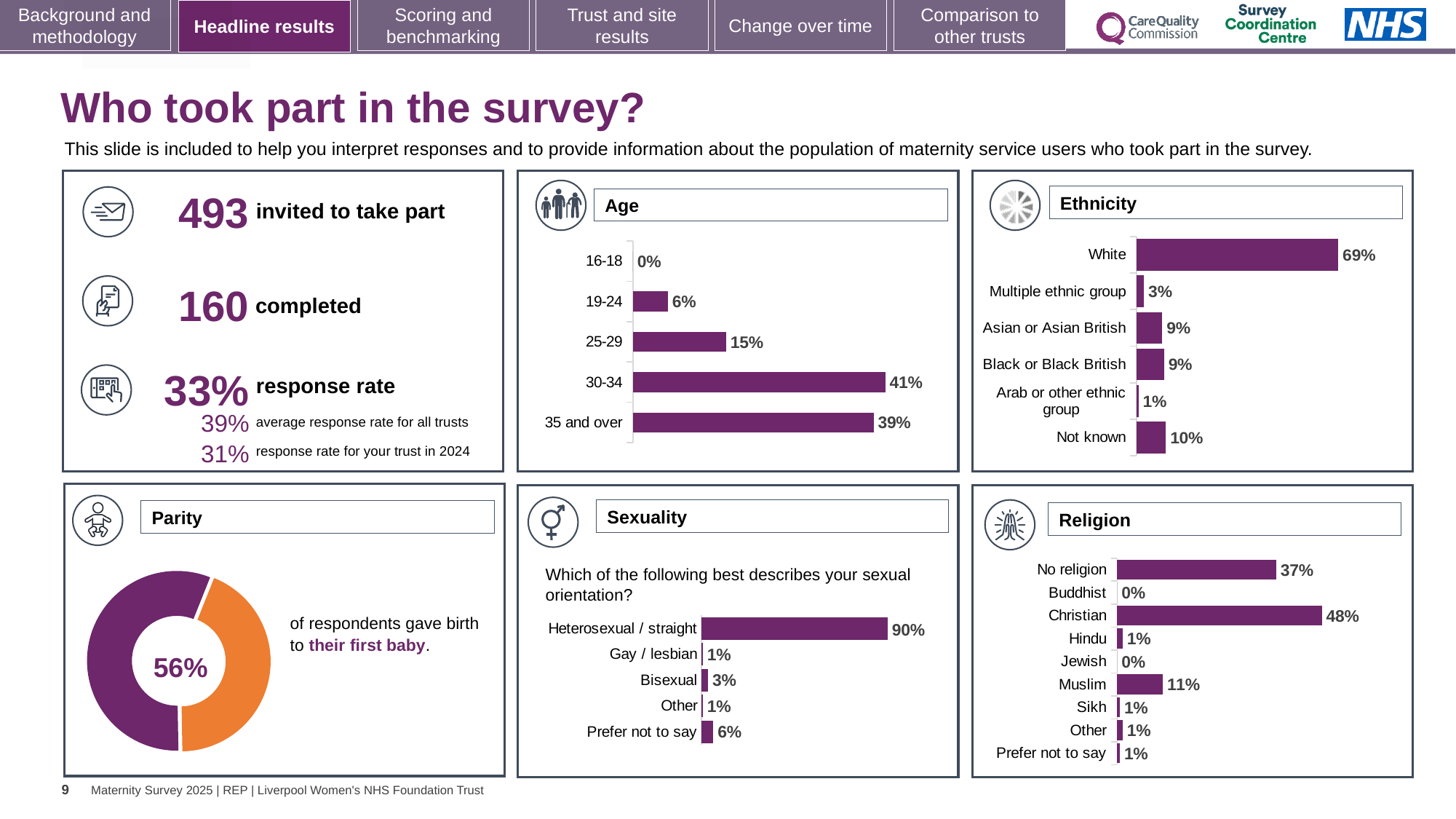
In the Sexuality chart, what percentage of respondents answered Heterosexual / straight? 90% What kind of chart is the Parity chart? Doughnut chart In the Religion chart, what percentage of respondents were Muslim? 11% In the Age chart, what percentage of respondents were aged 30-34? 41% In the Age chart, what is the difference between the 30-34 and 35 and over percentages? 2% How many categories are shown in the Ethnicity chart? 6 In the Ethnicity chart, what percentage of respondents were White? 69% In the Ethnicity chart, which category has the lowest percentage? Arab or other ethnic group In the Parity chart, what percentage of respondents gave birth to their first baby? 56% In the Sexuality chart, which is larger: Bisexual or Prefer not to say? Prefer not to say In the Age chart, which age group has the highest percentage? 30-34 In the Religion chart, what is the difference between Christian and No religion? 11%